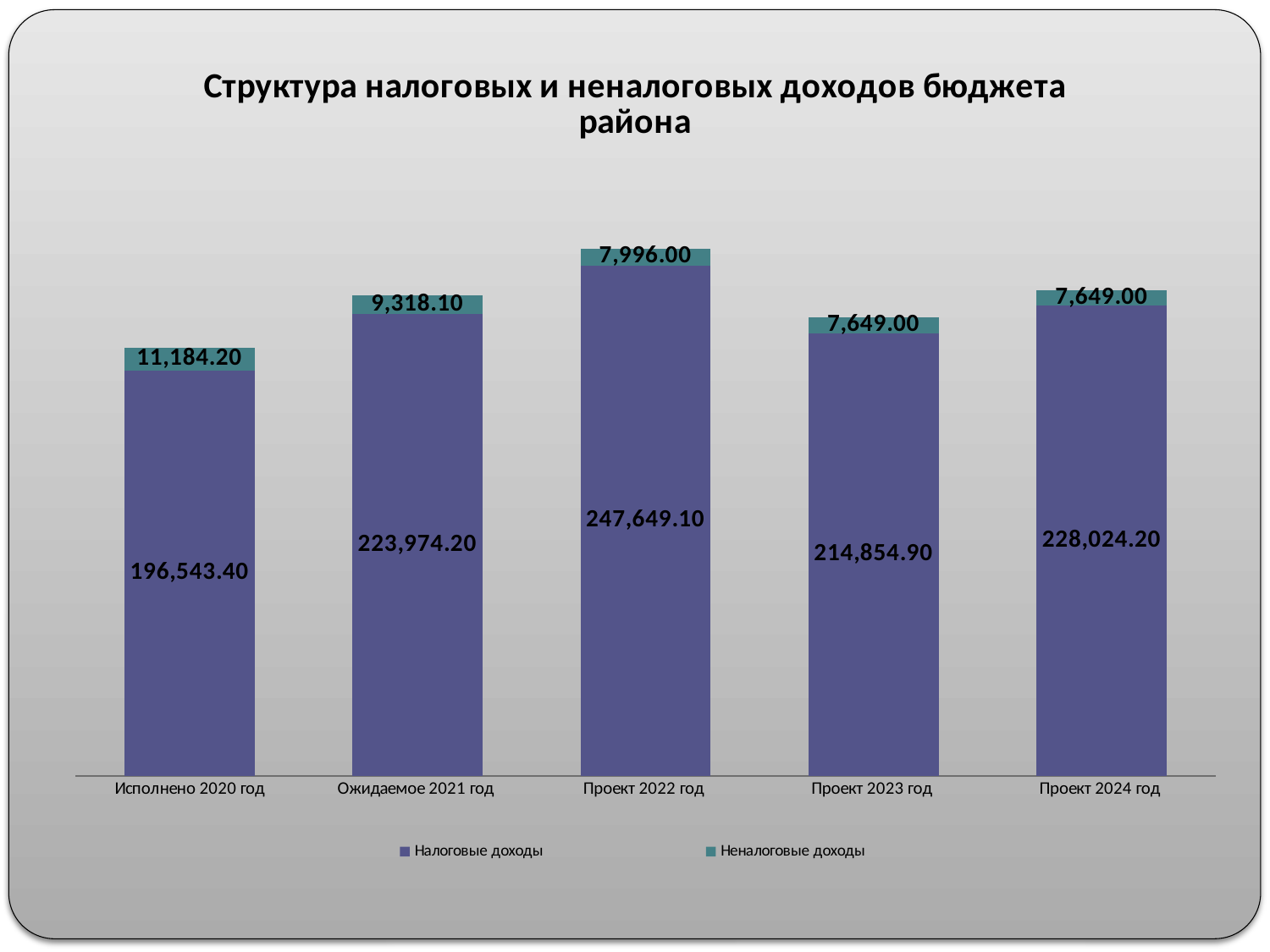
Which category has the lowest value of Налоговые доходы? Исполнено 2020 год Which category has the highest value of Налоговые доходы? Проект 2022 год Which is larger: Налоговые доходы for Проект 2023 год or for Проект 2024 год? Проект 2024 год What is the value of Неналоговые доходы for Исполнено 2020 год? 11,184.20 What is the value of Налоговые доходы for Проект 2022 год? 247,649.10 Which category has the highest value of Неналоговые доходы? Исполнено 2020 год How many series does the legend list? 2 What is the difference in Налоговые доходы between Проект 2022 год and Исполнено 2020 год? 51,105.70 What is the value of Налоговые доходы for Проект 2024 год? 228,024.20 What is the difference in Неналоговые доходы between Исполнено 2020 год and Ожидаемое 2021 год? 1,866.10 What is the total of the stacked bar for Проект 2022 год? 255,645.10 What type of chart is shown on the slide? Stacked bar chart